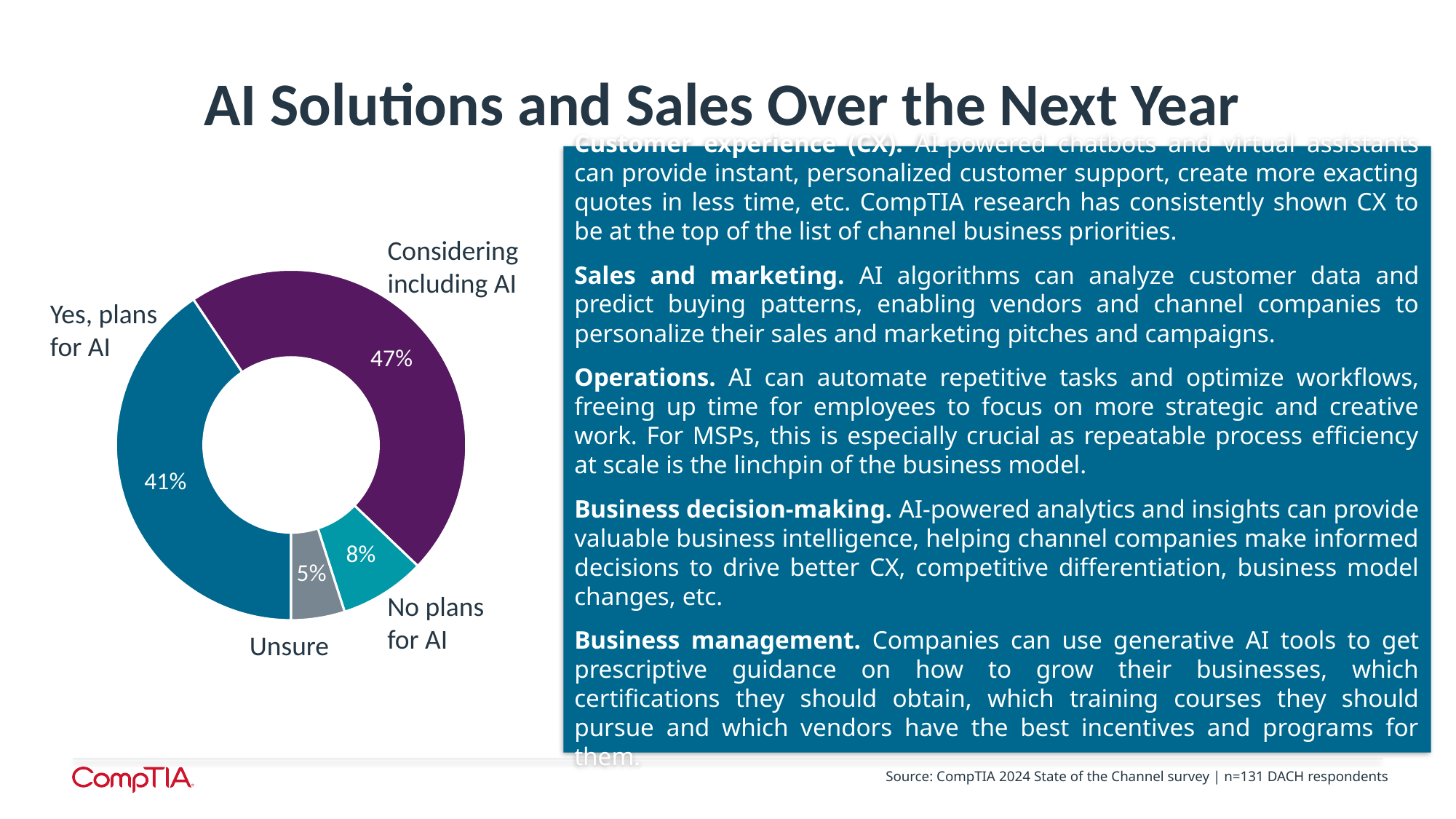
Which category has the smallest share of the chart? Unsure What colour is the 'Considering including AI' slice? Purple What percentage of respondents are unsure? 5% Which category has the largest share of the chart? Considering including AI How many categories are shown in the chart? 4 What is the difference in percentage points between 'Considering including AI' and 'Yes, plans for AI'? 6 Which is larger: the share for 'No plans for AI' or the share for 'Unsure'? No plans for AI What is the combined share of 'Yes, plans for AI' and 'Considering including AI'? 88% What percentage of respondents answered 'Yes, plans for AI'? 41% What percentage of respondents have no plans for AI? 8% What kind of chart is shown on the slide? Pie chart (donut) What percentage of respondents are considering including AI? 47%